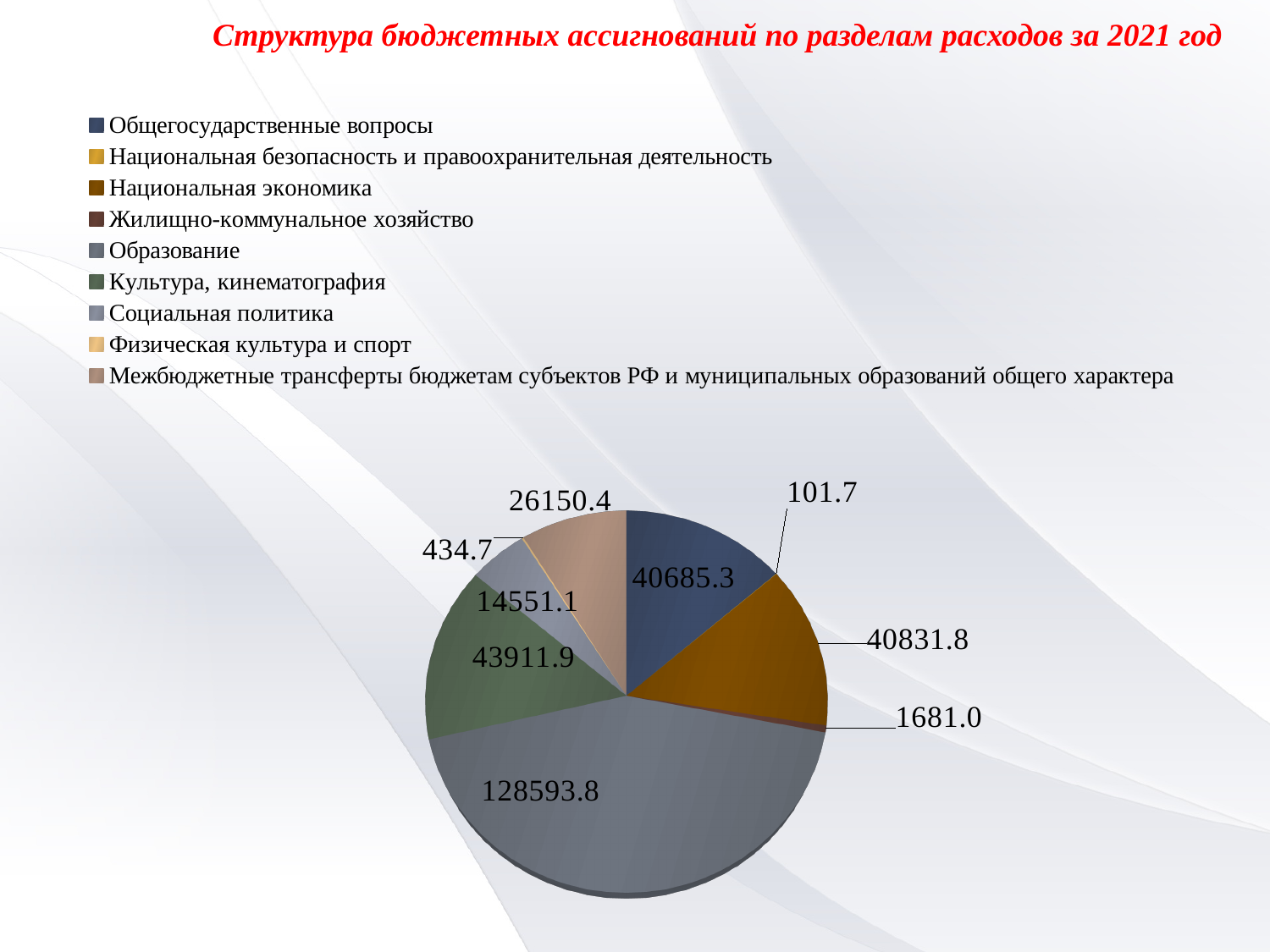
What is the title of the slide's chart? Структура бюджетных ассигнований по разделам расходов за 2021 год Which is larger, the value for Культура, кинематография or the value for Социальная политика? Культура, кинематография What is the value for Культура, кинематография? 43911.9 What type of chart is shown on the slide? pie chart What is the value for Жилищно-коммунальное хозяйство? 1681.0 What is the value for Образование? 128593.8 What is the difference between the values for Образование and Культура, кинематография? 84681.9 Which category has the largest slice of the pie? Образование What is the value for Межбюджетные трансферты бюджетам субъектов РФ и муниципальных образований общего характера? 26150.4 Which category has the smallest slice of the pie? Национальная безопасность и правоохранительная деятельность What is the value for Физическая культура и спорт? 434.7 How many categories does the pie chart show? 9